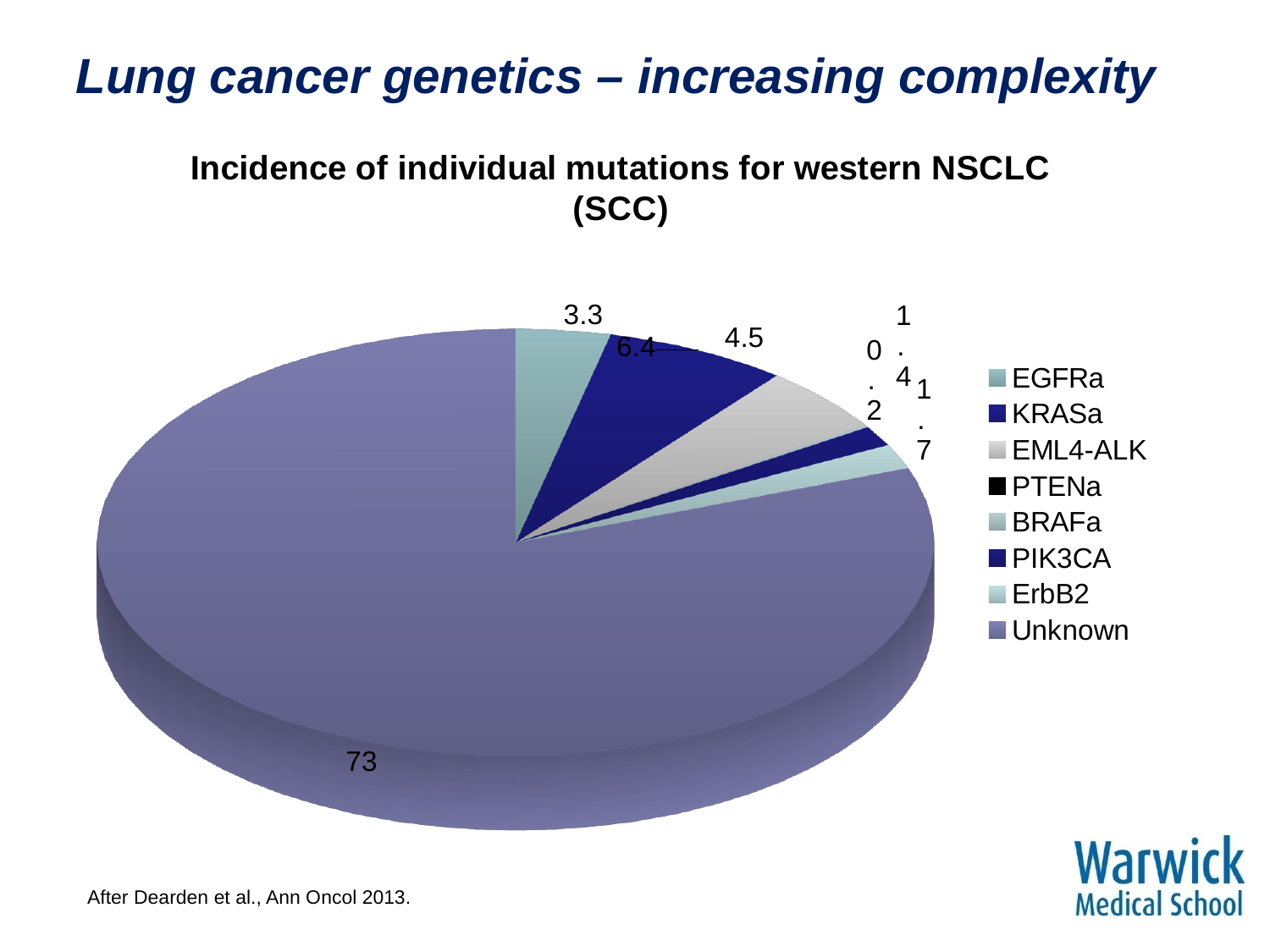
What is the difference between the KRASa value and the EGFRa value? 3.1 What value is shown for the EML4-ALK slice? 4.5 What is the difference between the Unknown value and the KRASa value? 66.6 What source is cited at the bottom of the slide? After Dearden et al., Ann Oncol 2013. Which category has the largest slice of the pie? Unknown What value is shown for the KRASa slice? 6.4 What value is shown for the EGFRa slice? 3.3 What value is shown for the Unknown slice? 73 How many entries does the chart legend list? 8 What kind of chart is shown on the slide? Pie chart Which is larger, the KRASa slice or the EML4-ALK slice? KRASa What is the title of the chart? Incidence of individual mutations for western NSCLC (SCC)